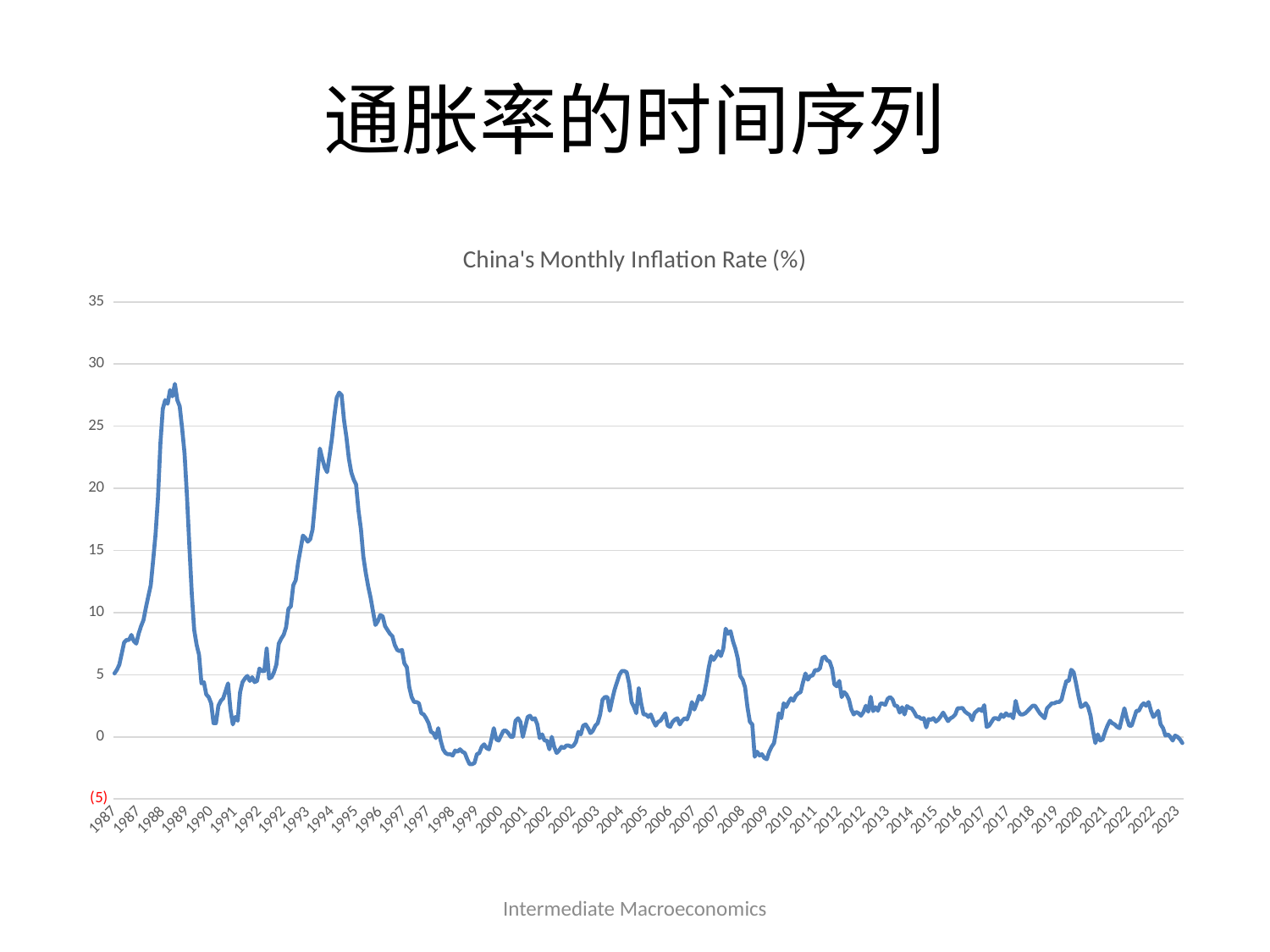
What is the highest value shown on the vertical axis? 35 Is the peak inflation rate around 2008 greater or less than 5? greater Does the inflation rate rise or fall between its 1994 peak and 1999? fall Is the peak inflation rate around 2011 greater or less than 5? greater Is the inflation rate at the end of 2023 greater or less than 5? less What kind of chart is shown on the slide? Line chart What is the title of the chart? China's Monthly Inflation Rate (%)